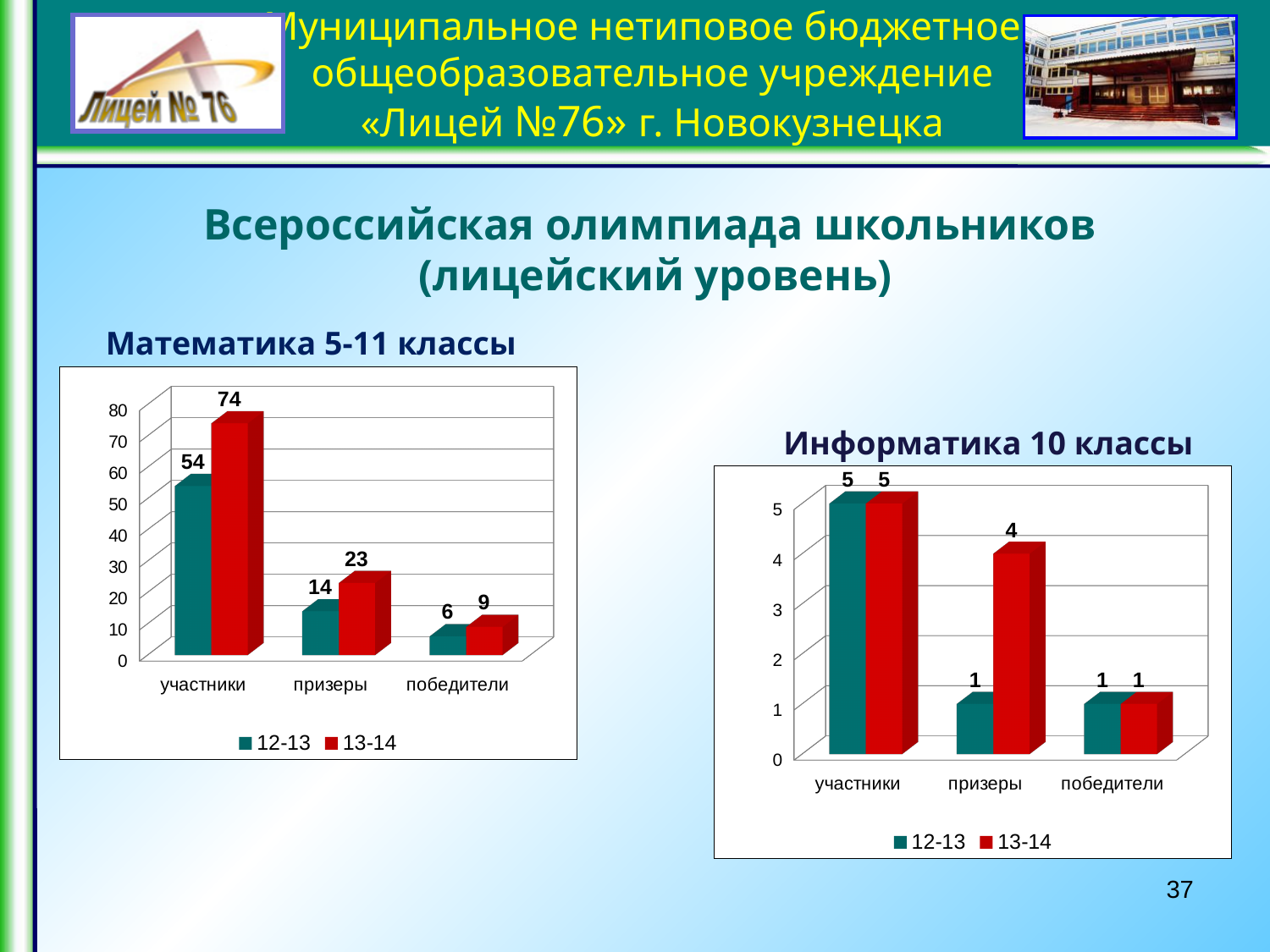
In the 'Информатика 10 классы' chart, what is the value for победители in the 12-13 series? 1 In the 'Математика 5-11 классы' chart, what is the value for участники in the 13-14 series? 74 In the 'Математика 5-11 классы' chart, which is larger for победители: the 12-13 value or the 13-14 value? 13-14 In the 'Информатика 10 классы' chart, what is the value for призеры in the 13-14 series? 4 How many series does the legend of the 'Информатика 10 классы' chart list? 2 What kind of chart is the 'Математика 5-11 классы' chart? bar chart In the 'Математика 5-11 классы' chart, how many categories are shown on the x axis? 3 In the 'Математика 5-11 классы' chart, which category has the highest value in the 12-13 series? участники In the 'Математика 5-11 классы' chart, what is the value for призеры in the 12-13 series? 14 In the 'Информатика 10 классы' chart, what is the difference between the 13-14 and 12-13 values for призеры? 3 In the 'Математика 5-11 классы' chart, what is the difference between the 13-14 and 12-13 values for участники? 20